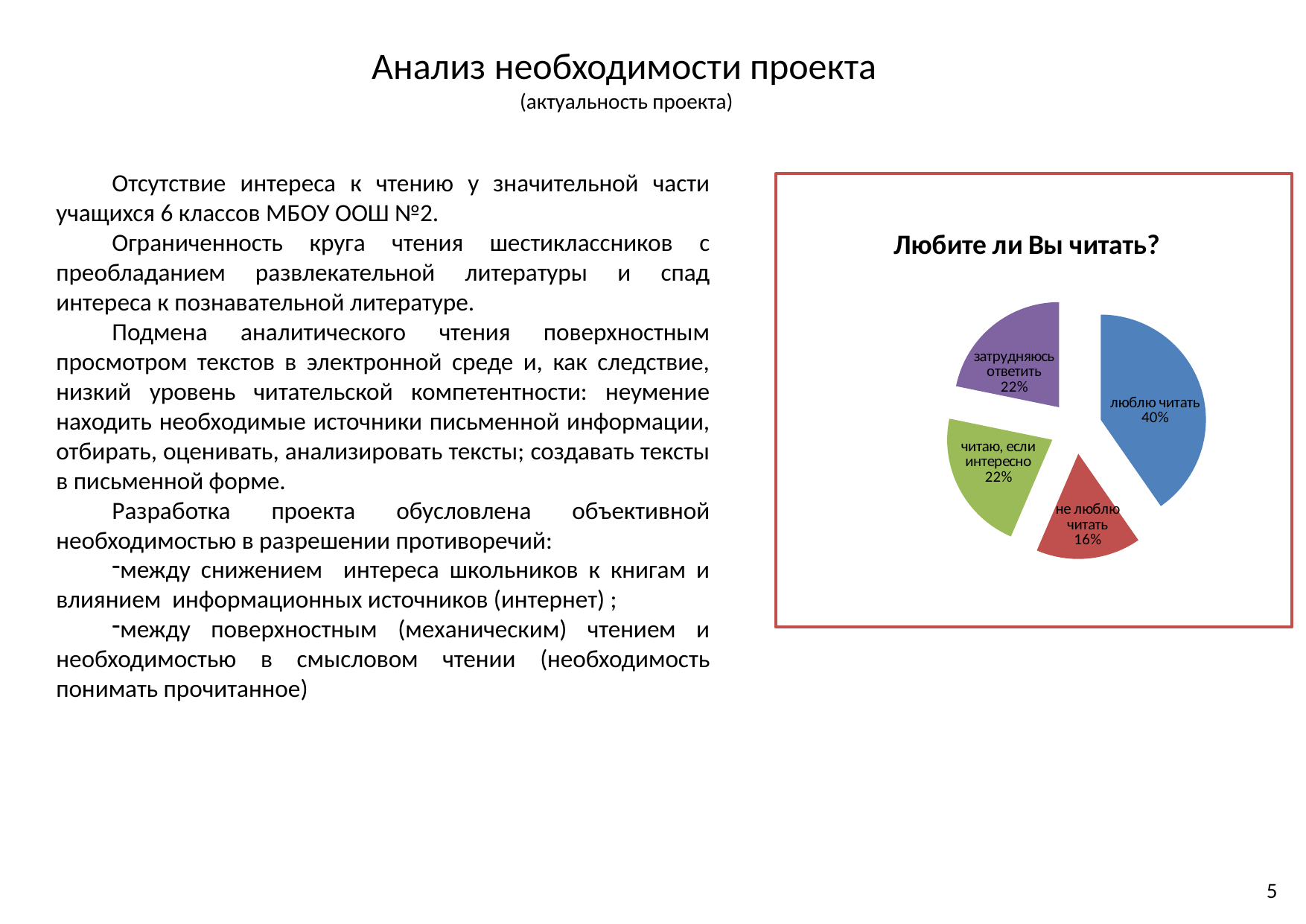
What share of respondents answered "не люблю читать"? 16% Which answer has the largest share of the pie? люблю читать What colour is the "люблю читать" slice? blue What share of respondents answered "читаю, если интересно"? 22% What is the difference in percentage points between "люблю читать" and "не люблю читать"? 24 What is the title of the chart? Любите ли Вы читать? Which is larger: the share for "люблю читать" or the share for "читаю, если интересно"? люблю читать How many slices does the pie chart have? 4 What type of chart is shown on the slide? pie chart Which answer has the smallest share of the pie? не люблю читать What share of respondents answered "затрудняюсь ответить"? 22% What share of respondents answered "люблю читать"? 40%